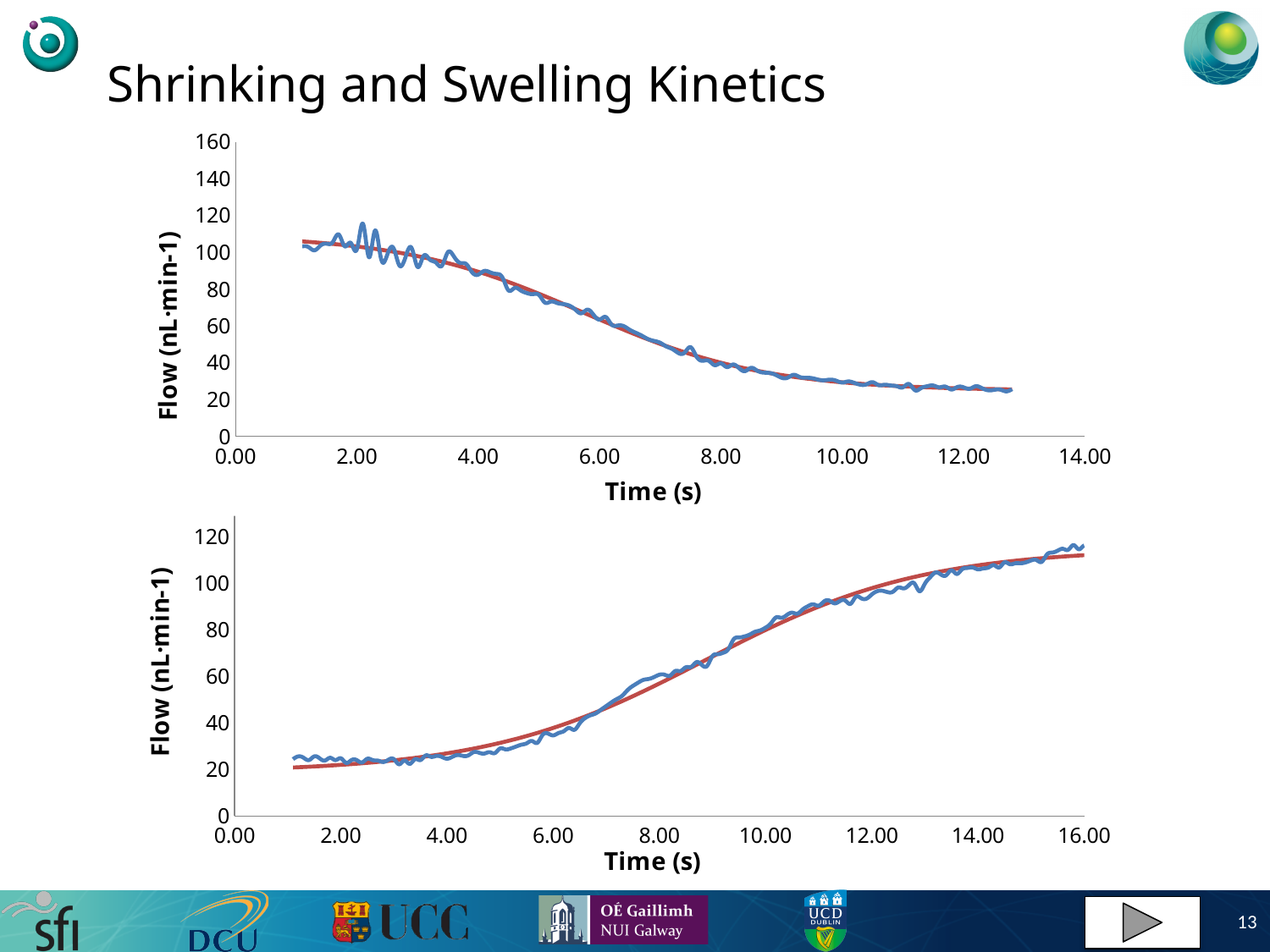
In the top chart, is the flow value at 2.00 s greater or less than 80? greater What kind of chart is the bottom chart on the slide? line chart What is the y-axis label of the top chart? Flow (nL·min-1) In the top chart, which is larger: the flow at 4.00 s or the flow at 10.00 s? the flow at 4.00 s In the top chart, is the flow value at 12.00 s greater or less than 40? less In the bottom chart, which is larger: the flow at 6.00 s or the flow at 12.00 s? the flow at 12.00 s What kind of chart is the top chart on the slide? line chart In the top chart, do the flow values rise or fall as time increases? fall What is the x-axis label of the bottom chart? Time (s) In the bottom chart, do the flow values rise or fall as time increases? rise In the bottom chart, is the flow value at 14.00 s greater or less than 100? greater